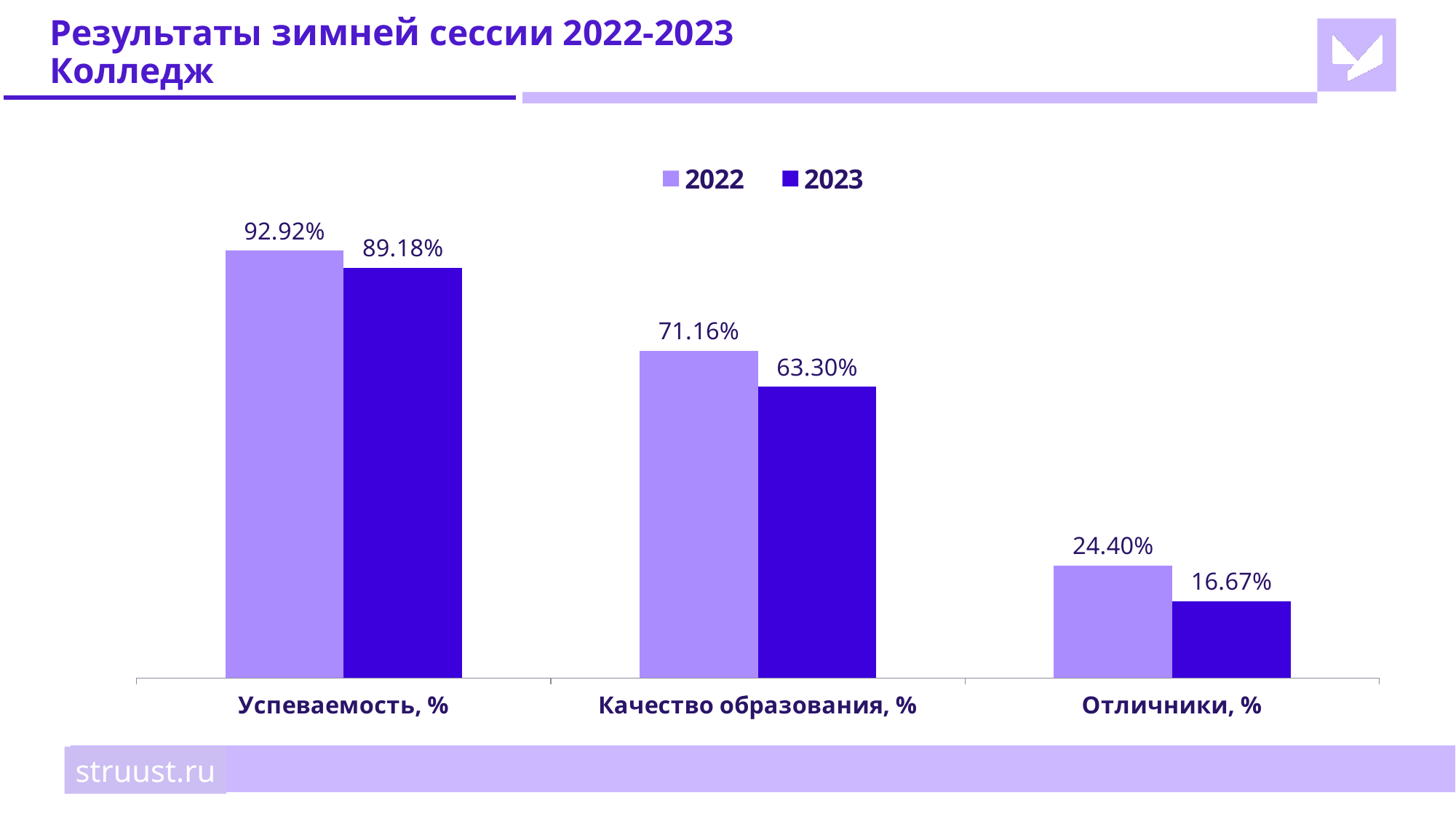
How many series does the legend list? 2 How many categories are shown on the x axis of the chart? 3 What is the value for 2023 in the Качество образования, % category? 63.30% What is the value for 2022 in the Отличники, % category? 24.40% In the Отличники, % category, which series has the larger value, 2022 or 2023? 2022 What kind of chart is shown on the slide? Bar chart What is the difference between the 2022 and 2023 values in the Успеваемость, % category? 3.74% Which category has the highest value for the 2023 series? Успеваемость, % Which category has the lowest value for the 2022 series? Отличники, % What is the difference between the 2022 and 2023 values in the Качество образования, % category? 7.86% What is the value for 2023 in the Отличники, % category? 16.67% What is the value for 2022 in the Успеваемость, % category? 92.92%